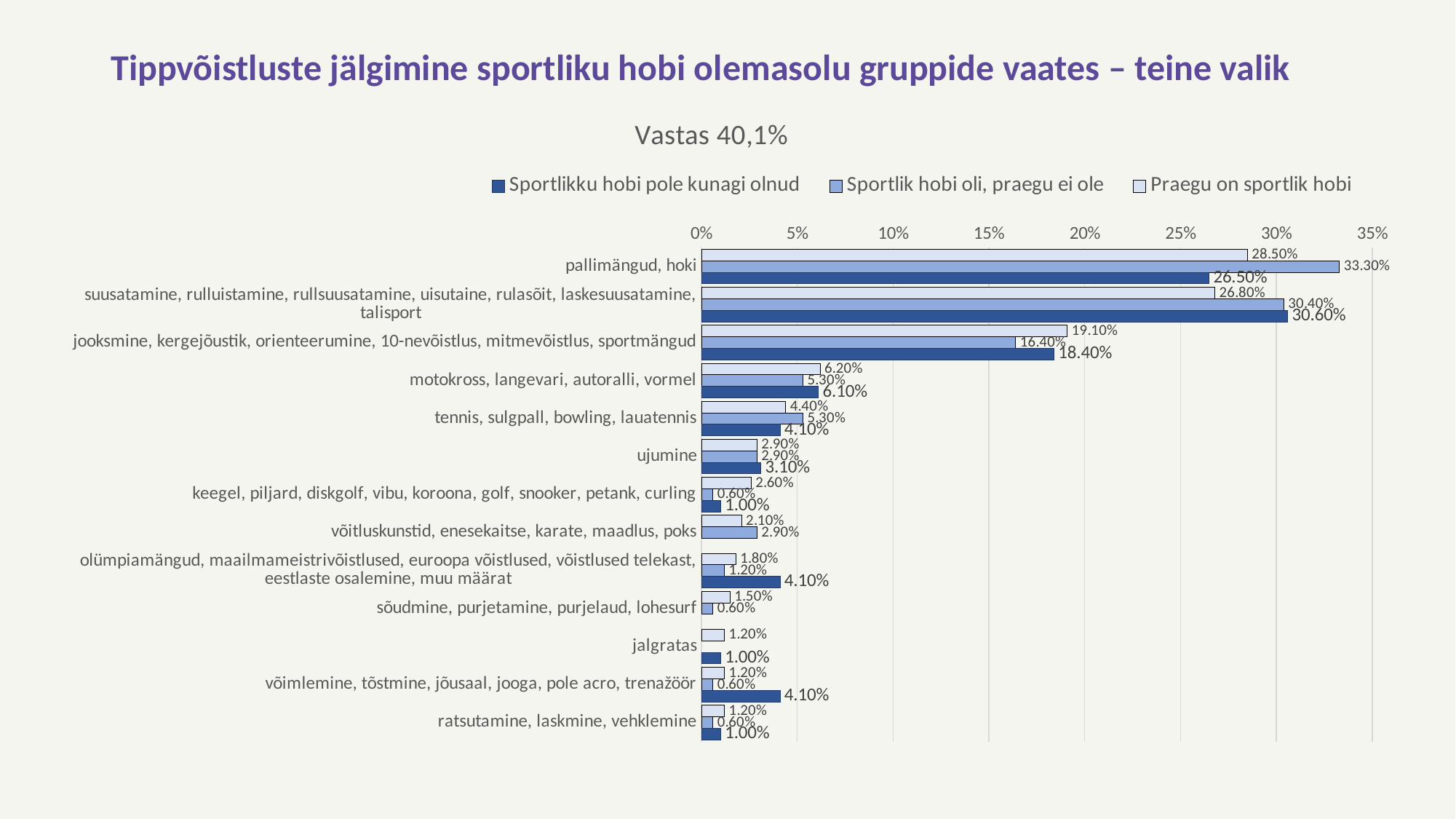
What is the subtitle shown above the chart legend? Vastas 40,1% What is the value for "pallimängud, hoki" in the "Sportlik hobi oli, praegu ei ole" series? 33.30% Which category has the highest value in the "Praegu on sportlik hobi" series? pallimängud, hoki What is the difference between the "Praegu on sportlik hobi" and "Sportlik hobi oli, praegu ei ole" values for "jooksmine, kergejõustik, orienteerumine, 10-nevõistlus, mitmevõistlus, sportmängud"? 2.70% What kind of chart is shown on the slide? Bar chart How many categories are shown on the chart? 13 How many series does the legend list? 3 What is the value for "motokross, langevari, autoralli, vormel" in the "Sportlik hobi oli, praegu ei ole" series? 5.30% What is the difference between the "Sportlik hobi oli, praegu ei ole" and "Sportlikku hobi pole kunagi olnud" values for "pallimängud, hoki"? 6.80% What is the value for "jooksmine, kergejõustik, orienteerumine, 10-nevõistlus, mitmevõistlus, sportmängud" in the "Praegu on sportlik hobi" series? 19.10% What is the value for "ujumine" in the "Sportlikku hobi pole kunagi olnud" series? 3.10% For "keegel, piljard, diskgolf, vibu, koroona, golf, snooker, petank, curling", which series has the larger value: "Praegu on sportlik hobi" or "Sportlikku hobi pole kunagi olnud"? Praegu on sportlik hobi